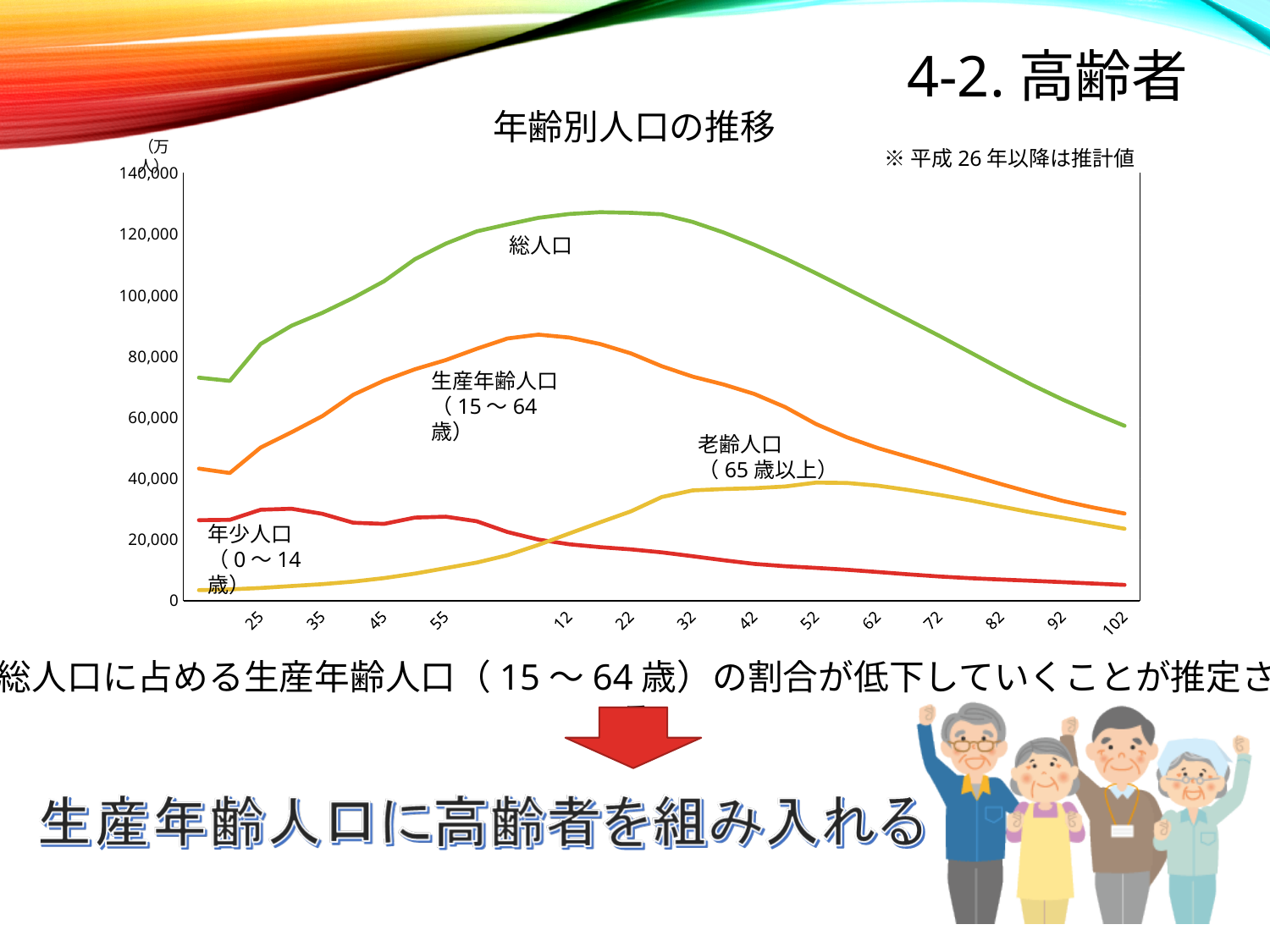
Which series has the lowest value at the right end of the chart (102)? 年少人口（0～14歳） Is the value of 年少人口（0～14歳） at 102 greater or less than 20,000? less Is the peak value of 生産年齢人口（15～64歳） greater or less than 80,000? greater Is the peak value of 総人口 greater or less than 120,000? greater Does 老齢人口（65歳以上） rise or fall between 25 and 52 on the x axis? rise What is the title of the chart? 年齢別人口の推移 Which series has the highest values across the whole chart? 総人口 What kind of chart is shown on the slide? line chart At 52 on the x axis, which is larger: 生産年齢人口（15～64歳） or 老齢人口（65歳以上）? 生産年齢人口（15～64歳） How many population series are plotted on the chart? 4 Does 総人口 rise or fall between 22 and 102 on the x axis? fall